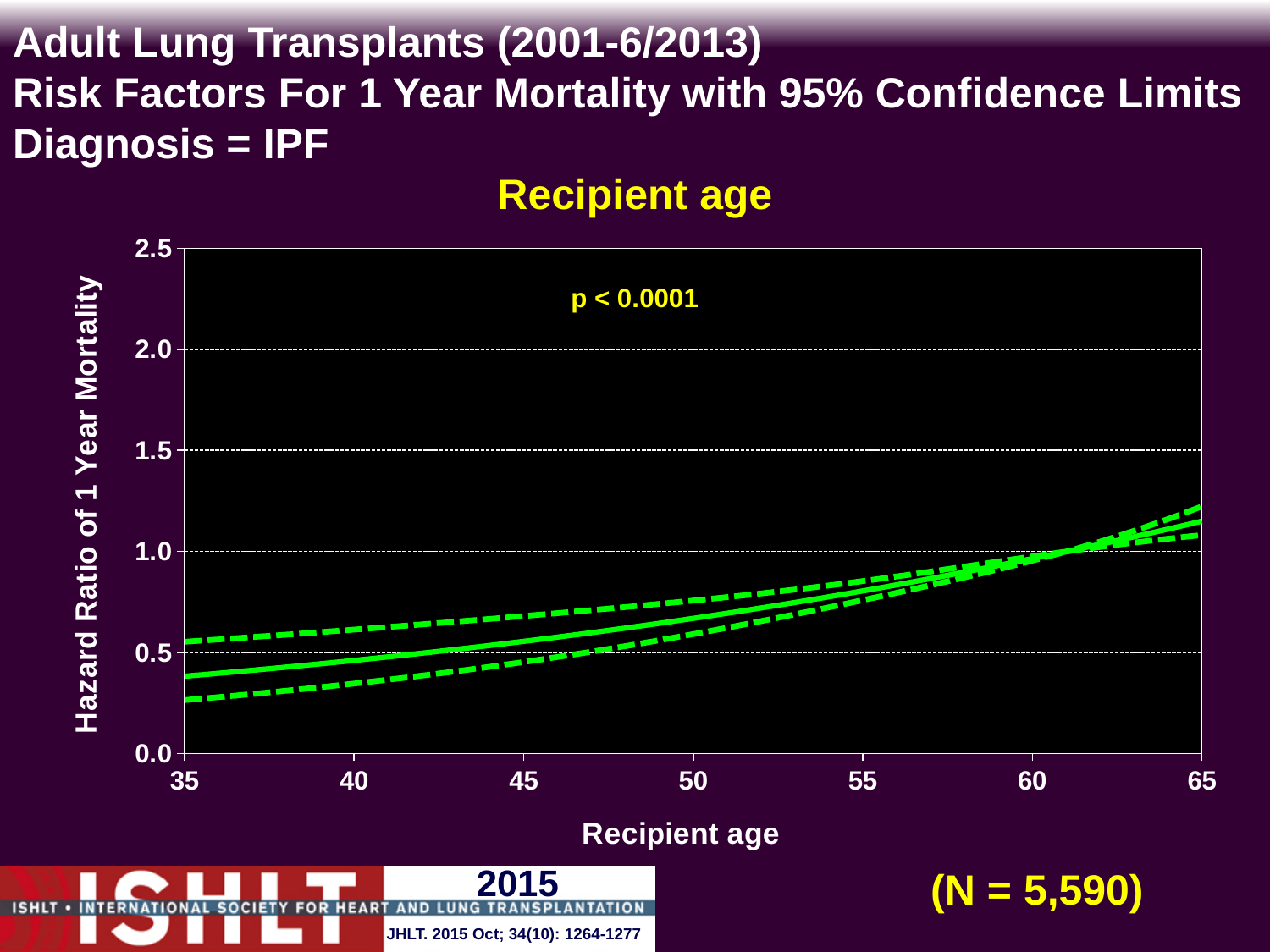
What is the sample size (N) shown on the slide? N = 5,590 How many lines are plotted on the chart? 3 Does the hazard ratio of 1 year mortality rise or fall as recipient age increases from 35 to 65? rise Which is larger, the hazard ratio at recipient age 40 or at recipient age 60? recipient age 60 Is the hazard ratio (solid line) at recipient age 35 greater or less than 0.5? less Is the hazard ratio (solid line) at recipient age 55 greater or less than 1.5? less What p-value is printed on the chart? p < 0.0001 Is the hazard ratio (solid line) at recipient age 65 greater or less than 1.0? greater What kind of chart is shown on the slide? line chart